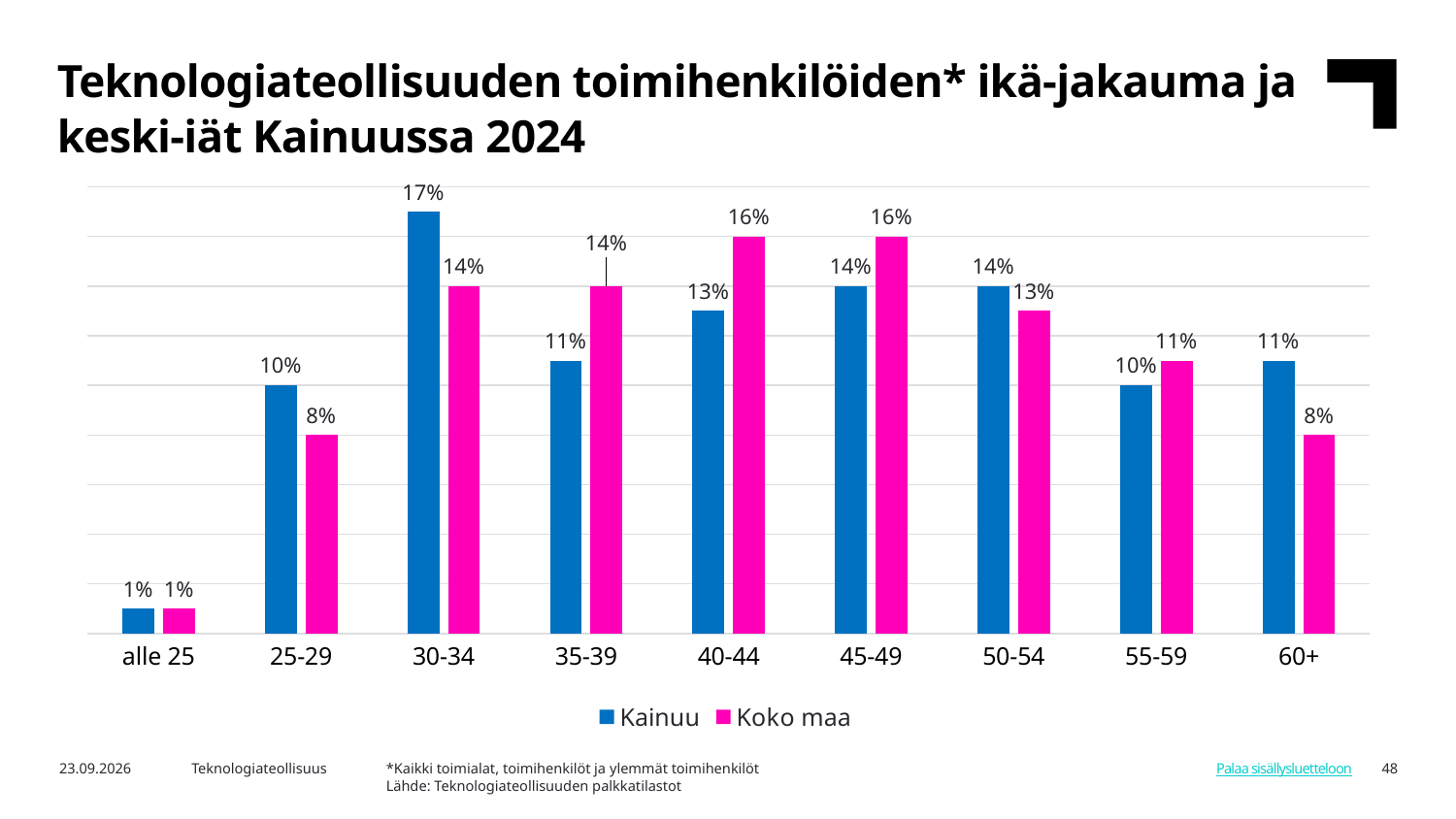
What is the Kainuu value for the 40-44 age group? 13% What is the difference between the Kainuu and Koko maa values for the 30-34 age group? 3 percentage points How many series does the legend list? 2 What is the Koko maa value for the 60+ age group? 8% Which series is shown in pink? Koko maa Which age group has the highest Kainuu value? 30-34 How many age groups are shown on the x axis? 9 What is the Koko maa value for the 25-29 age group? 8% What is the Kainuu value for the 30-34 age group? 17% Which is larger for the 35-39 age group, the Kainuu value or the Koko maa value? Koko maa What kind of chart is shown on the slide? Bar chart Which age group has the lowest Kainuu value? alle 25